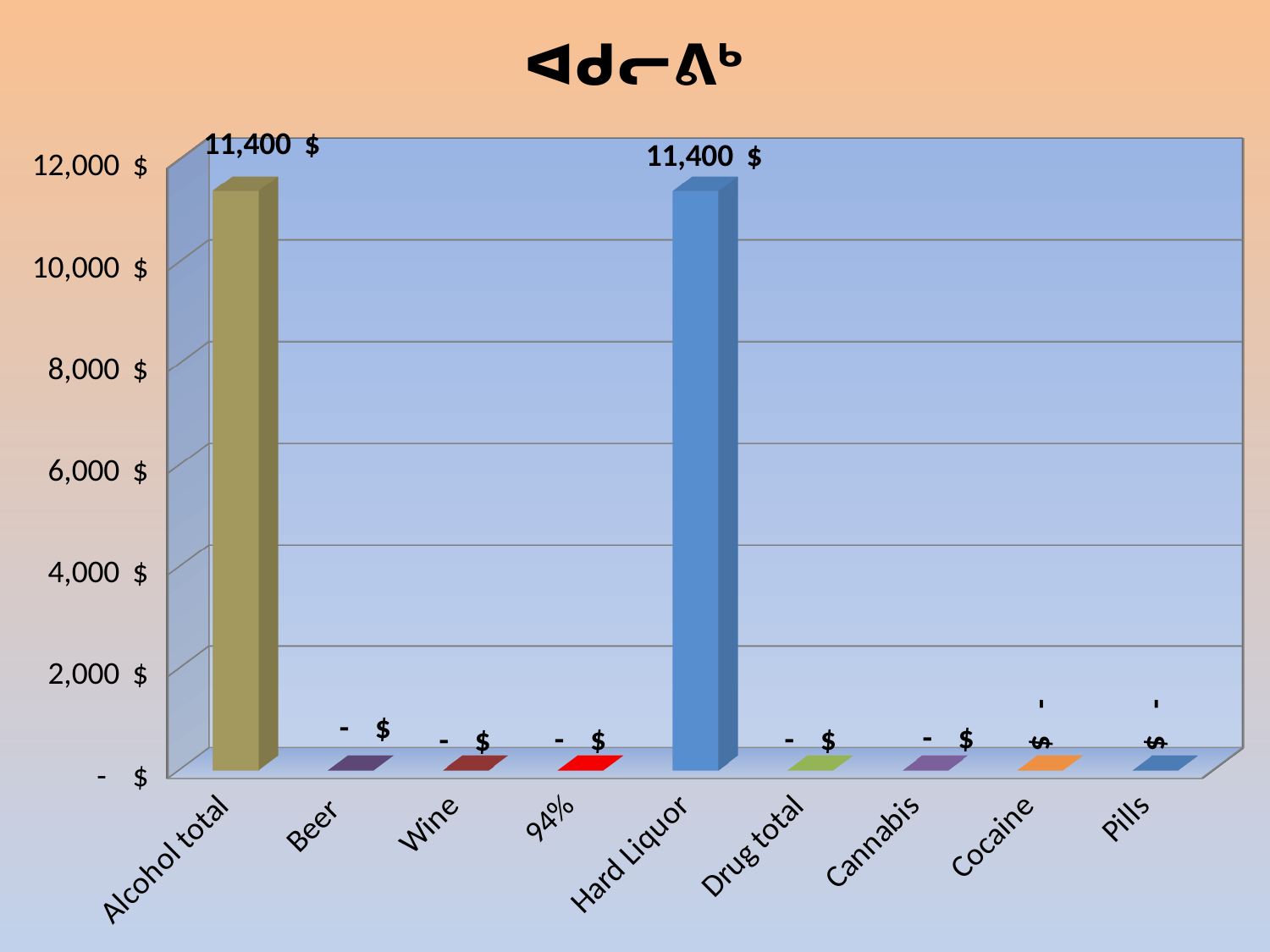
How many categories are shown on the x axis? 9 Is the value for Cannabis greater or less than 2,000 $? less Which is larger, the value for Hard Liquor or the value for Drug total? Hard Liquor Which is larger, the value for Alcohol total or the value for Beer? Alcohol total What kind of chart is shown on the slide? bar chart What is the highest value labelled on the vertical axis? 12,000 $ Is the value for Hard Liquor greater or less than 10,000 $? greater What is the value for Alcohol total? 11,400 $ What is the difference between the value for Alcohol total and the value for Hard Liquor? 0 $ How many categories have a value of 11,400 $? 2 Which two categories share the highest value? Alcohol total and Hard Liquor What is the value for Hard Liquor? 11,400 $